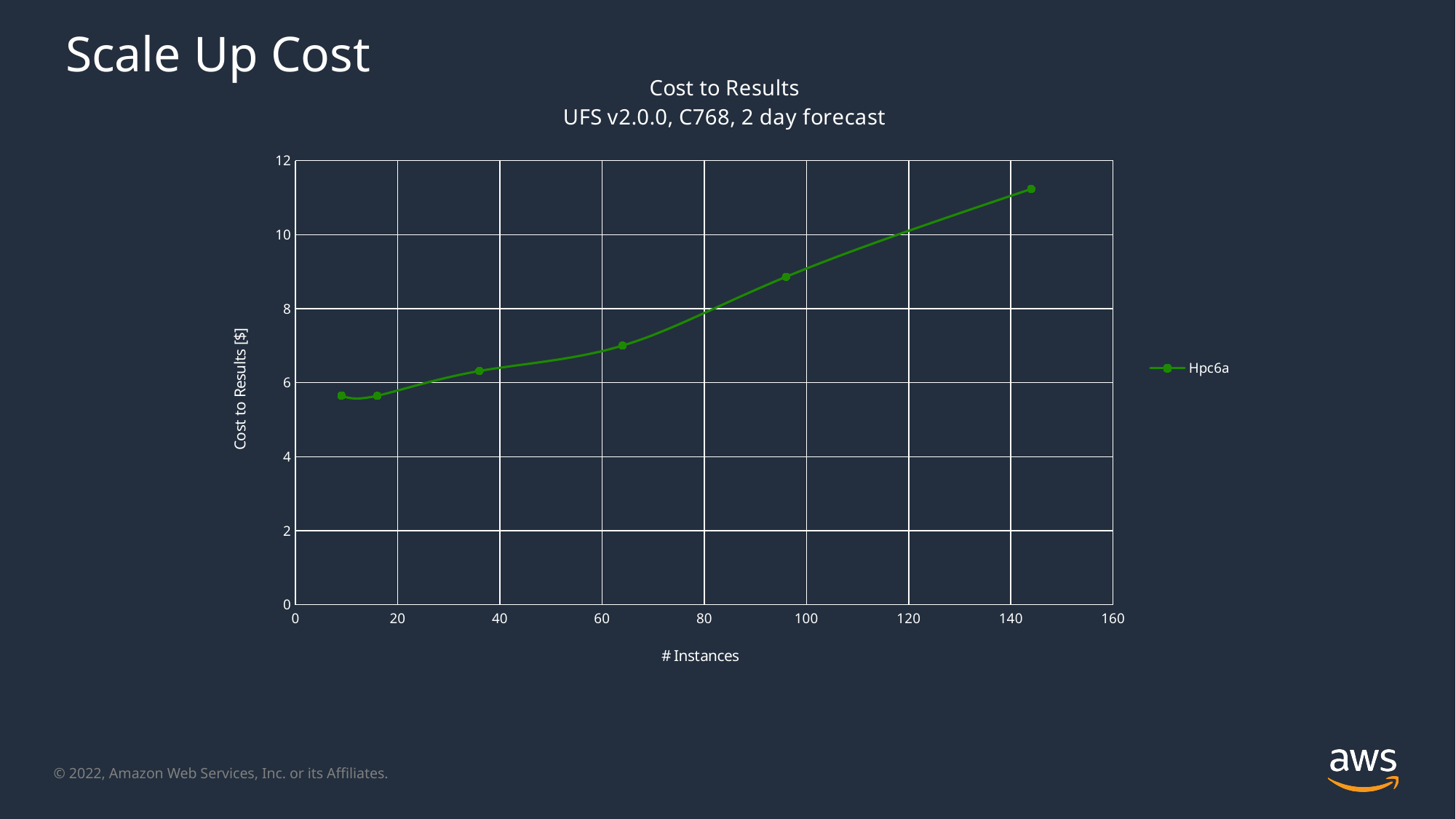
Does the cost to results rise or fall as the number of instances increases? rises What is the label of the y axis? Cost to Results [$] Is the cost to results for the data point at about 96 instances greater or less than 8? greater How many data points are plotted on the Hpc6a line? 6 How many series does the legend list? 1 Is the cost to results for the leftmost data point greater or less than 6? less Is the cost to results for the data point at about 64 instances greater or less than 8? less What kind of chart is shown on the slide? line chart What is the maximum value shown on the x axis? 160 What is the name of the series shown in the legend? Hpc6a Which data point has the highest cost to results: the one at about 96 instances or the rightmost one at about 144 instances? the rightmost one at about 144 instances